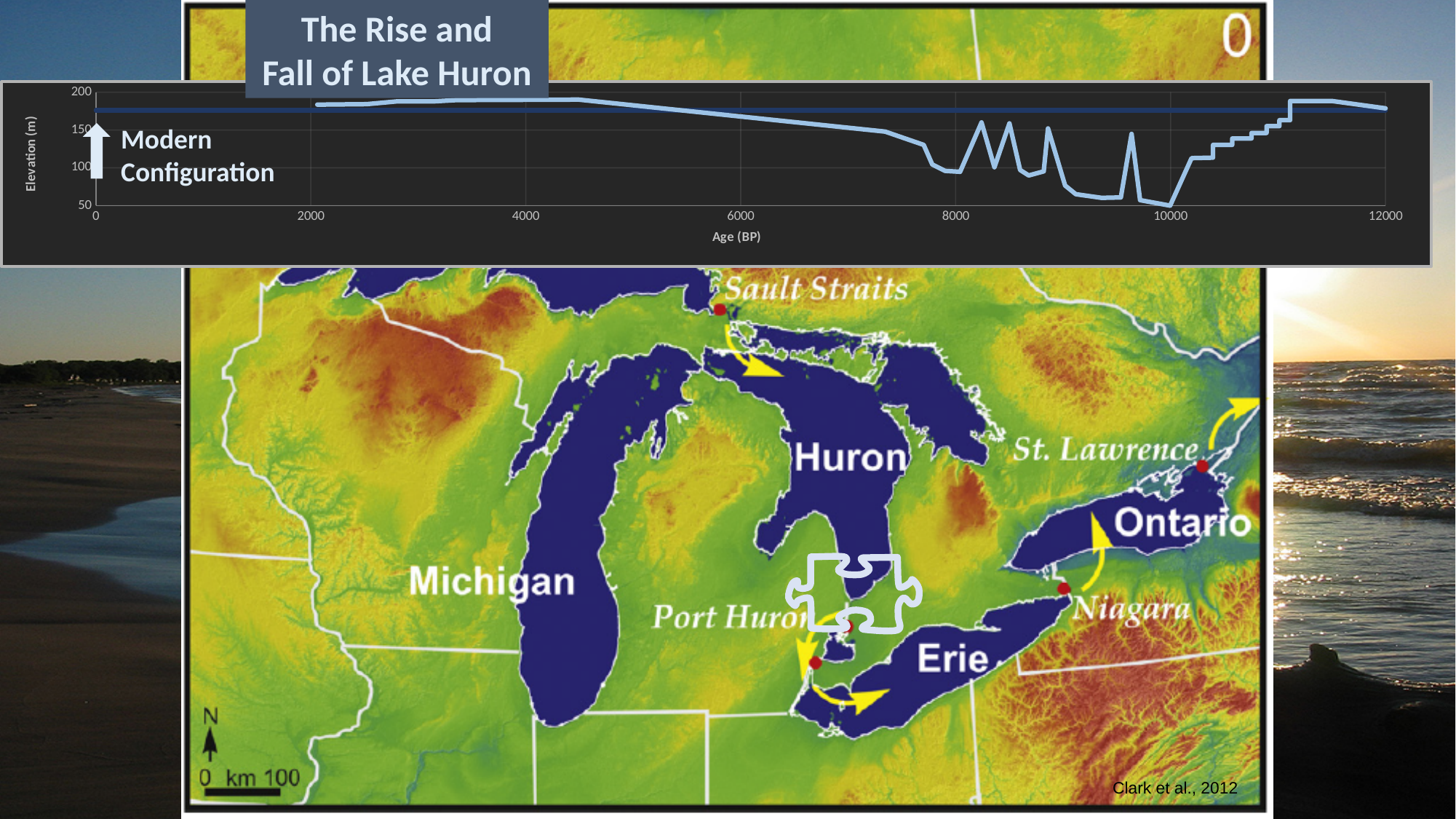
Which is higher on the light blue line: the elevation at 4000 BP or at 10000 BP? 4000 BP Which is higher on the light blue line: the elevation at 6000 BP or at 9000 BP? 6000 BP Is the elevation shown by the light blue line at 10000 BP greater or less than 100? less What kind of chart is shown at the top of the slide? line chart Near which x-axis tick does the light blue line reach its lowest elevation? 10000 Is the elevation shown by the light blue line at 6000 BP greater or less than 150? greater How many tick labels are shown on the x axis of the chart? 7 Is the elevation shown by the light blue line at 4000 BP greater or less than 150? greater Between 10000 BP and 12000 BP, does the light blue line generally rise or fall as age increases? rise What is the title of the chart at the top of the slide? The Rise and Fall of Lake Huron What is the label on the x axis of the chart? Age (BP)